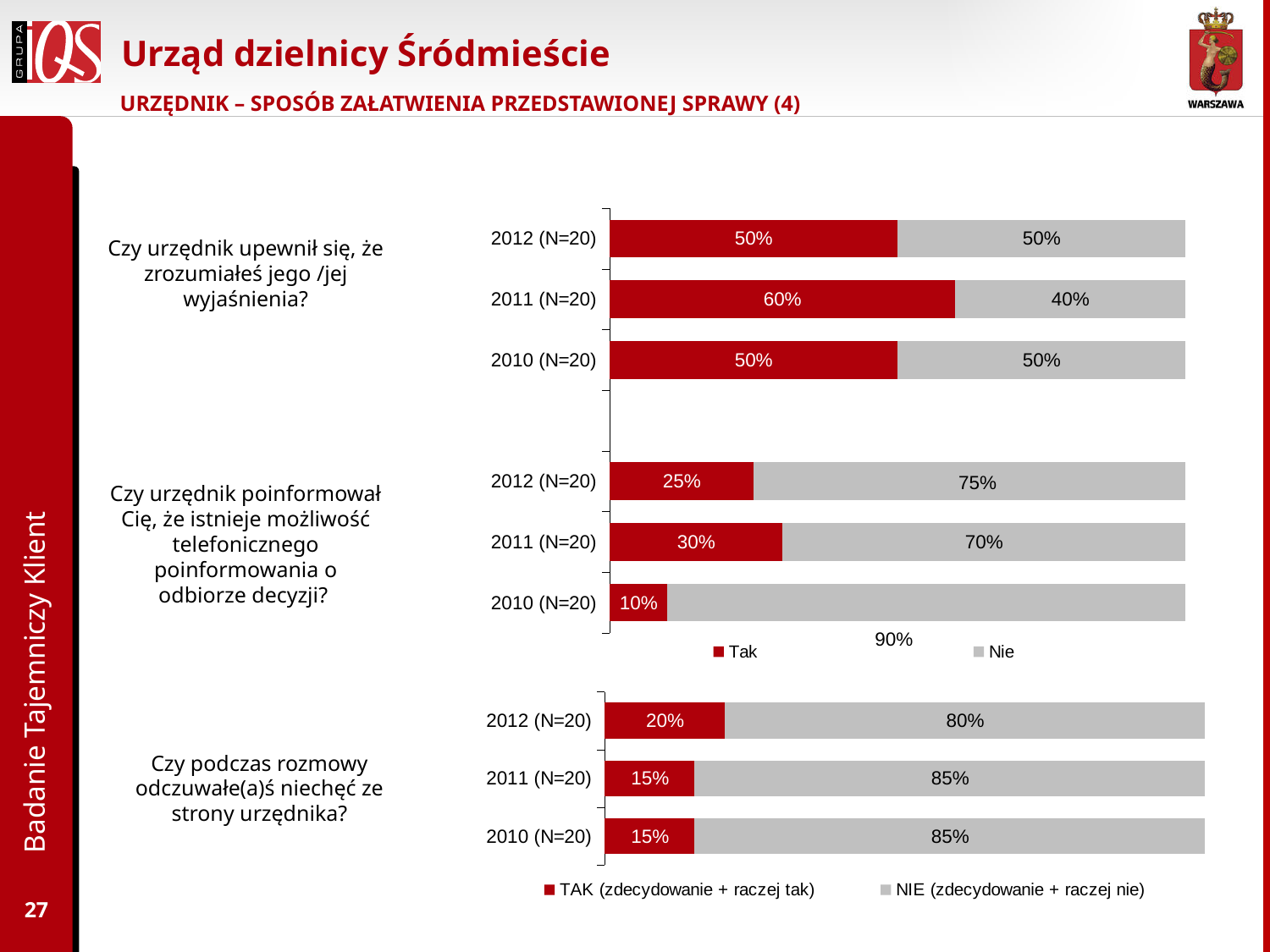
In the chart for "Czy podczas rozmowy odczuwałe(a)ś niechęć ze strony urzędnika?", is the TAK value for 2012 (N=20) larger or smaller than the TAK value for 2011 (N=20)? larger In the chart for "Czy podczas rozmowy odczuwałe(a)ś niechęć ze strony urzędnika?", which year has the lowest NIE value? 2012 (N=20) In the bottom chart, what colour represents the TAK (zdecydowanie + raczej tak) series? Red In the chart for "Czy urzędnik poinformował Cię, że istnieje możliwość telefonicznego poinformowania o odbiorze decyzji?", what is the Tak value for 2010 (N=20)? 10% What kind of chart is used for "Czy podczas rozmowy odczuwałe(a)ś niechęć ze strony urzędnika?"? Stacked bar chart In the chart for "Czy urzędnik upewnił się, że zrozumiałeś jego /jej wyjaśnienia?", what is the Tak value for 2011 (N=20)? 60% In the chart for "Czy podczas rozmowy odczuwałe(a)ś niechęć ze strony urzędnika?", what is the TAK value for 2012 (N=20)? 20% In the chart for "Czy urzędnik upewnił się, że zrozumiałeś jego /jej wyjaśnienia?", how many year categories are shown? 3 In the chart for "Czy urzędnik upewnił się, że zrozumiałeś jego /jej wyjaśnienia?", what is the Nie value for 2012 (N=20)? 50% In the chart for "Czy podczas rozmowy odczuwałe(a)ś niechęć ze strony urzędnika?", how many series does the legend list? 2 In the chart for "Czy urzędnik poinformował Cię, że istnieje możliwość telefonicznego poinformowania o odbiorze decyzji?", what is the difference between the Nie values for 2012 (N=20) and 2011 (N=20)? 5% In the chart for "Czy urzędnik poinformował Cię, że istnieje możliwość telefonicznego poinformowania o odbiorze decyzji?", which year has the highest Tak value? 2011 (N=20)